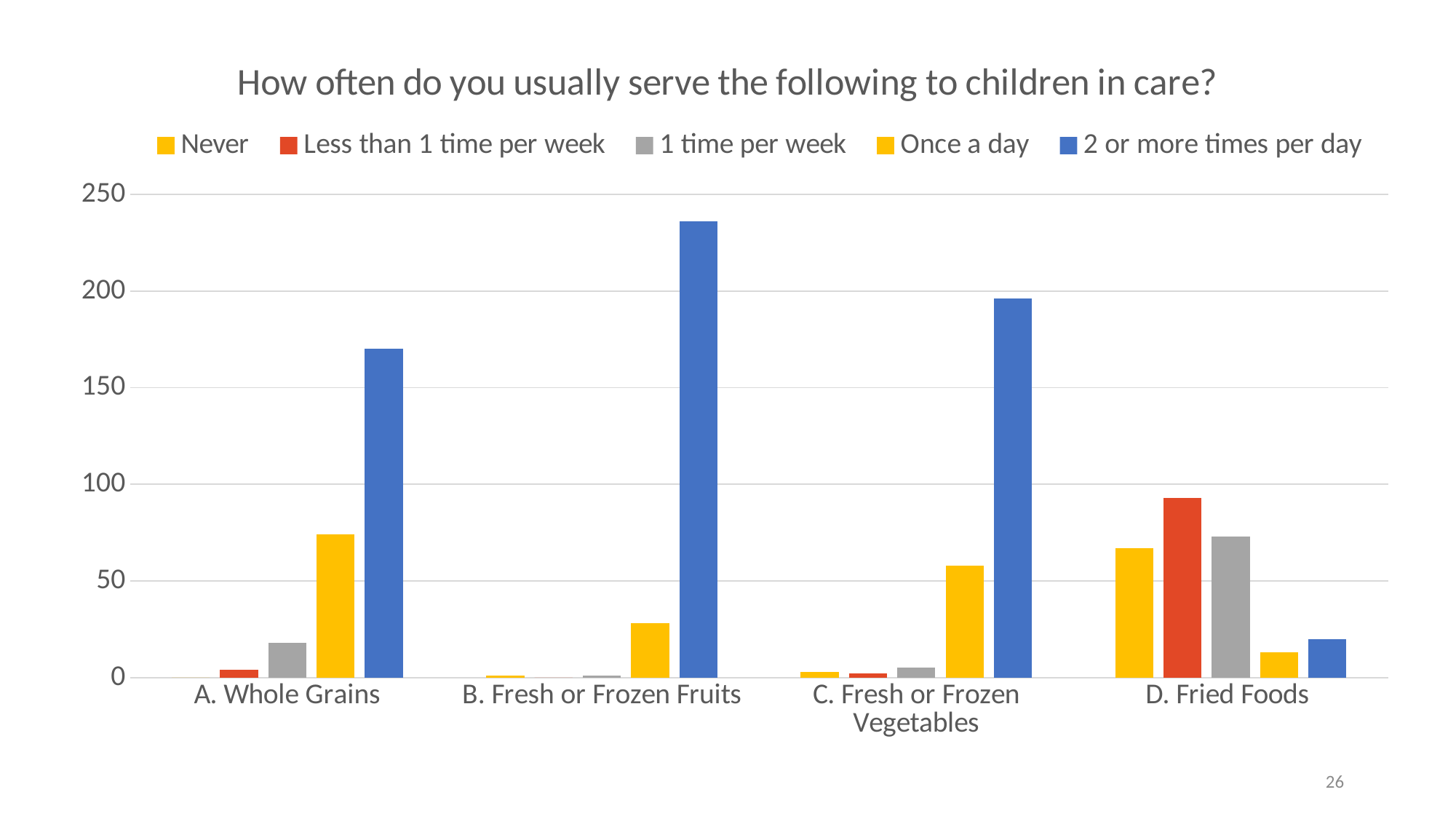
How many food categories are shown along the x axis? 4 For D. Fried Foods, which is larger: 'Less than 1 time per week' or '1 time per week'? Less than 1 time per week For D. Fried Foods, which response option has the tallest bar? Less than 1 time per week What kind of chart is shown on the slide? Bar chart Is the 'Once a day' value for D. Fried Foods greater or less than 50? less Which is larger: the 'Once a day' value for A. Whole Grains or for C. Fresh or Frozen Vegetables? A. Whole Grains What is the title of the chart? How often do you usually serve the following to children in care? Which food category has the tallest '2 or more times per day' bar? B. Fresh or Frozen Fruits Which food category has the shortest '2 or more times per day' bar? D. Fried Foods Is the '2 or more times per day' value for B. Fresh or Frozen Fruits greater or less than 200? greater How many series does the legend list? 5 Is the '2 or more times per day' value for A. Whole Grains greater or less than 150? greater